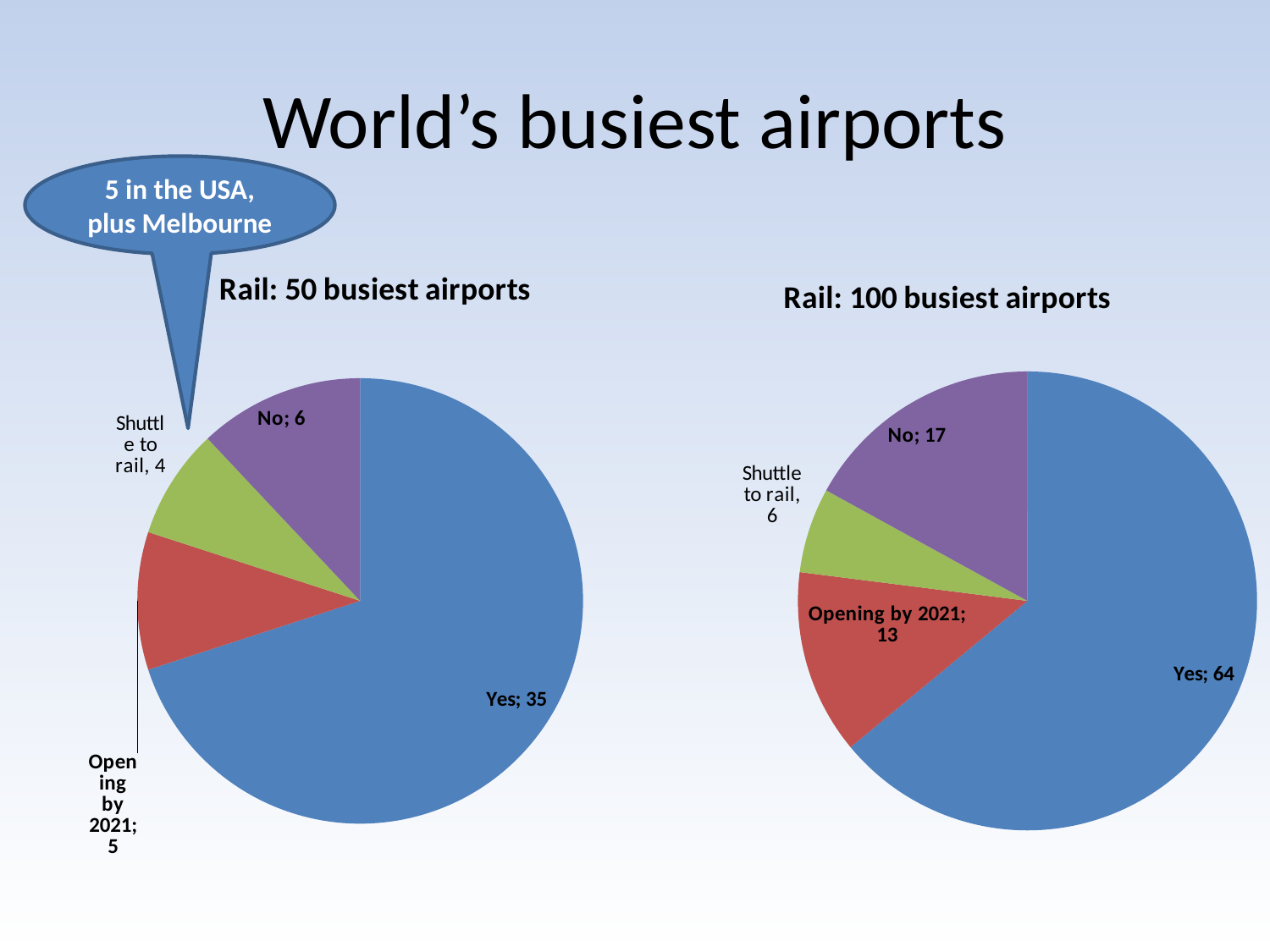
In the 'Rail: 100 busiest airports' chart, which category has the largest slice? Yes In the 'Rail: 50 busiest airports' chart, which category has the smallest slice? Shuttle to rail In the 'Rail: 50 busiest airports' chart, which is larger, No or Opening by 2021? No In the 'Rail: 100 busiest airports' chart, what is the value for Opening by 2021? 13 How many slices does the 'Rail: 50 busiest airports' pie chart have? 4 What is the title of the pie chart on the left of the slide? Rail: 50 busiest airports In the 'Rail: 50 busiest airports' chart, what share of the pie does the Yes slice represent? 70% In the 'Rail: 50 busiest airports' chart, what is the value for Yes? 35 In the 'Rail: 100 busiest airports' chart, what share of the pie does the Yes slice represent? 64% In the 'Rail: 100 busiest airports' chart, what is the value for No? 17 In the 'Rail: 100 busiest airports' chart, what is the difference between the No and Shuttle to rail values? 11 What type of chart is the 'Rail: 100 busiest airports' chart? Pie chart